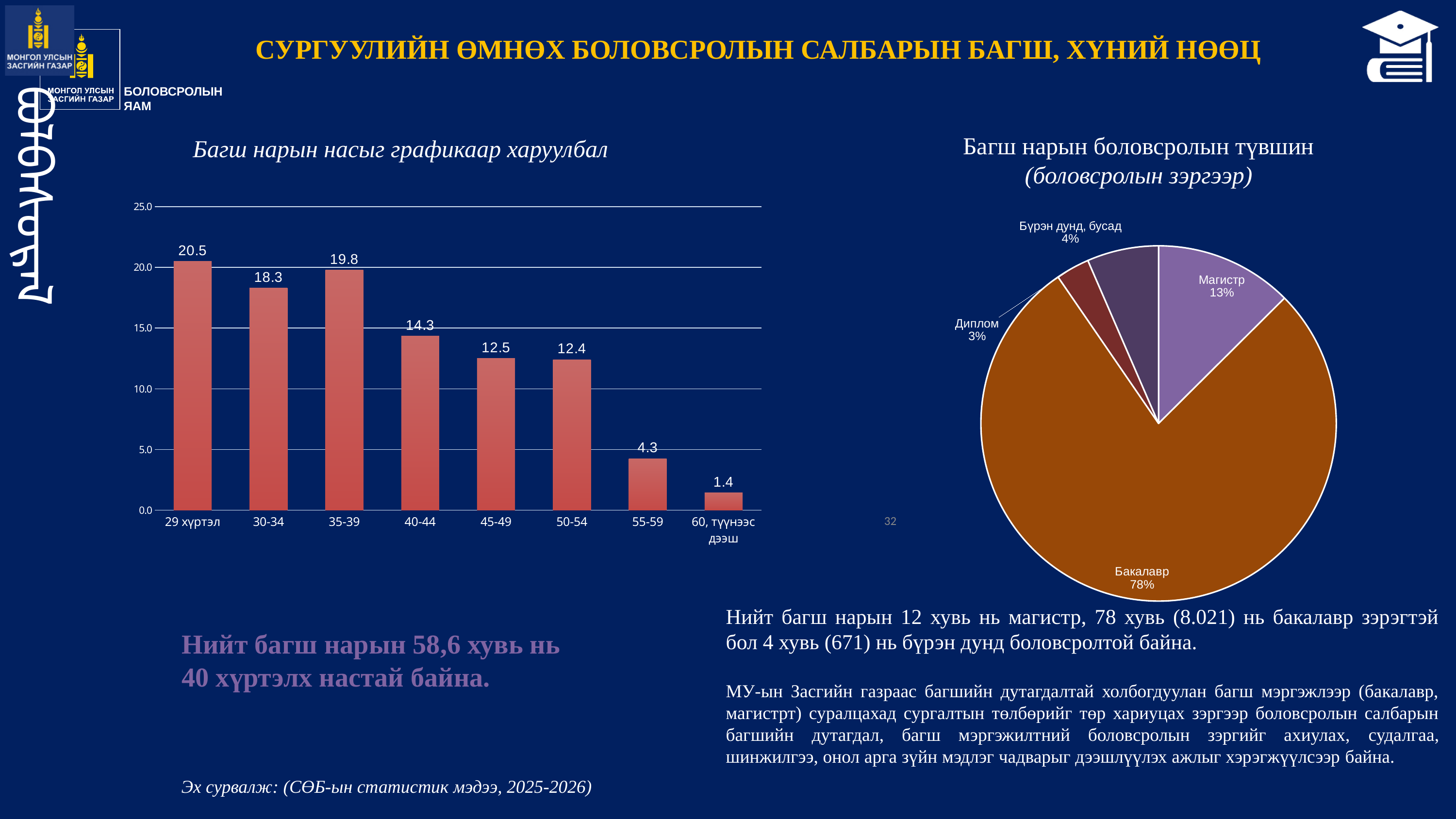
What kind of chart is the chart on the left of the slide? Bar chart In the bar chart on the left, what is the difference between the values for 35-39 and 30-34? 1.5 In the bar chart on the left, which age group has the lowest value? 60, түүнээс дээш In the bar chart on the left, what is the value for the 29 хүртэл age group? 20.5 In the bar chart on the left, what is the value for the 40-44 age group? 14.3 In the pie chart on the right, what share of the pie does Бакалавр have? 78% In the bar chart on the left, which is larger: the value for 45-49 or the value for 55-59? 45-49 In the pie chart on the right, which category has the smallest slice? Диплом What kind of chart is the chart on the right of the slide? Pie chart In the pie chart on the right, what share of the pie does Магистр have? 13% In the bar chart on the left, how many age groups are shown? 8 In the bar chart on the left, which age group has the highest value? 29 хүртэл